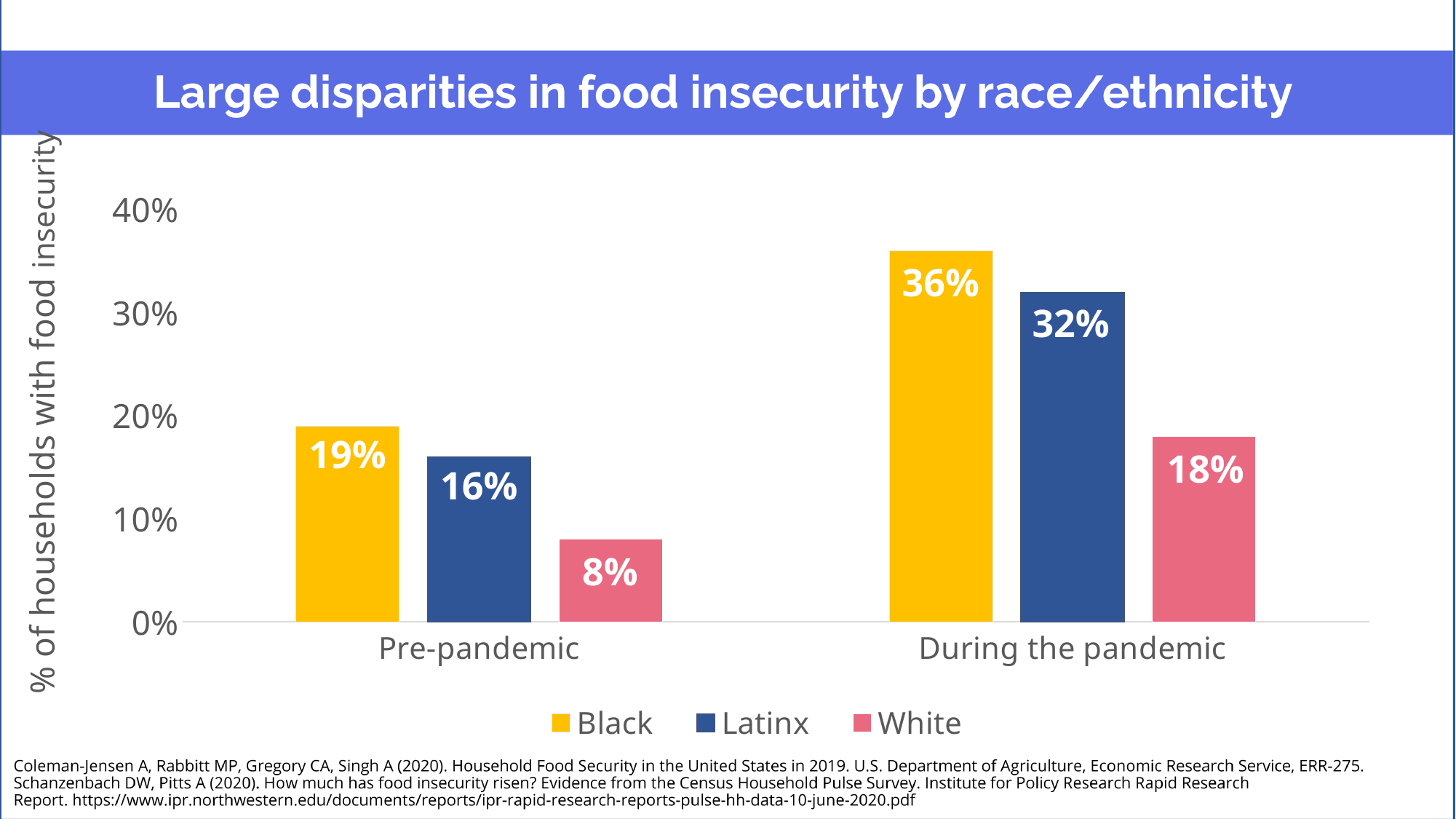
How many categories are shown on the x axis? 2 What is the difference between the Black and White values during the pandemic? 18% Which is larger: the Latinx value during the pandemic or the Black value pre-pandemic? Latinx during the pandemic Which series has the lowest value in the Pre-pandemic category? White What is the title of the chart? Large disparities in food insecurity by race/ethnicity What is the value for Latinx households in the Pre-pandemic category? 16% What is the difference between the Latinx value during the pandemic and the Latinx value pre-pandemic? 16% Which series has the highest value in the During the pandemic category? Black What is the value for Black households in the Pre-pandemic category? 19% What is the value for White households during the pandemic? 18% What kind of chart is shown on the slide? Bar chart How many series does the legend list? 3